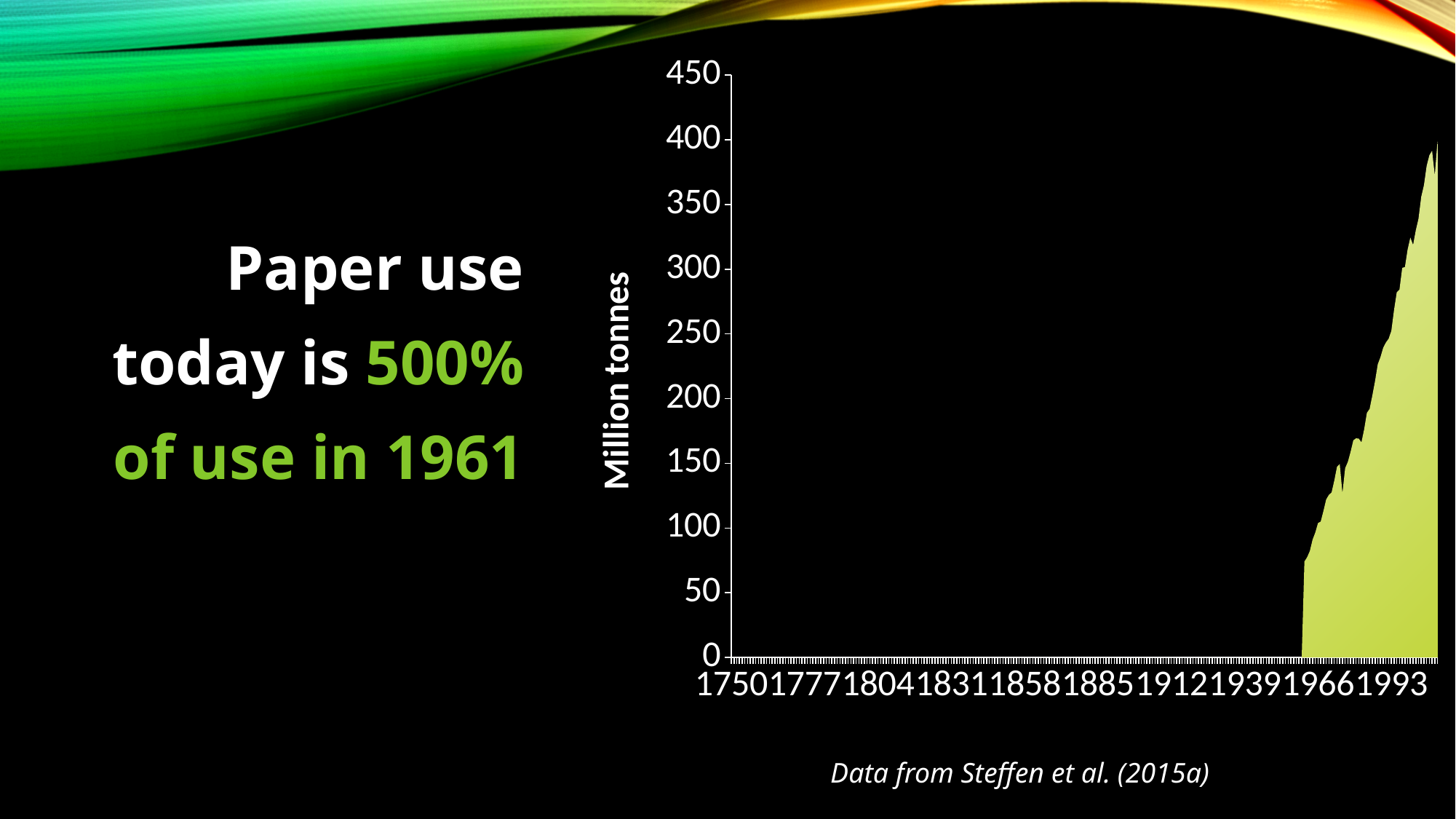
What is the highest tick value shown on the vertical axis? 450 Is the value for 1993 greater or less than 150? greater What kind of chart is shown on the slide? area chart Is the value at the right-hand end of the chart (the most recent year) greater or less than 300? greater What is the label on the vertical axis of the chart? Million tonnes What is the first year label on the x axis of the chart? 1750 How many year labels are shown along the x axis of the chart? 10 Do the values in the chart rise or fall as the years move toward the right end of the x axis? rise